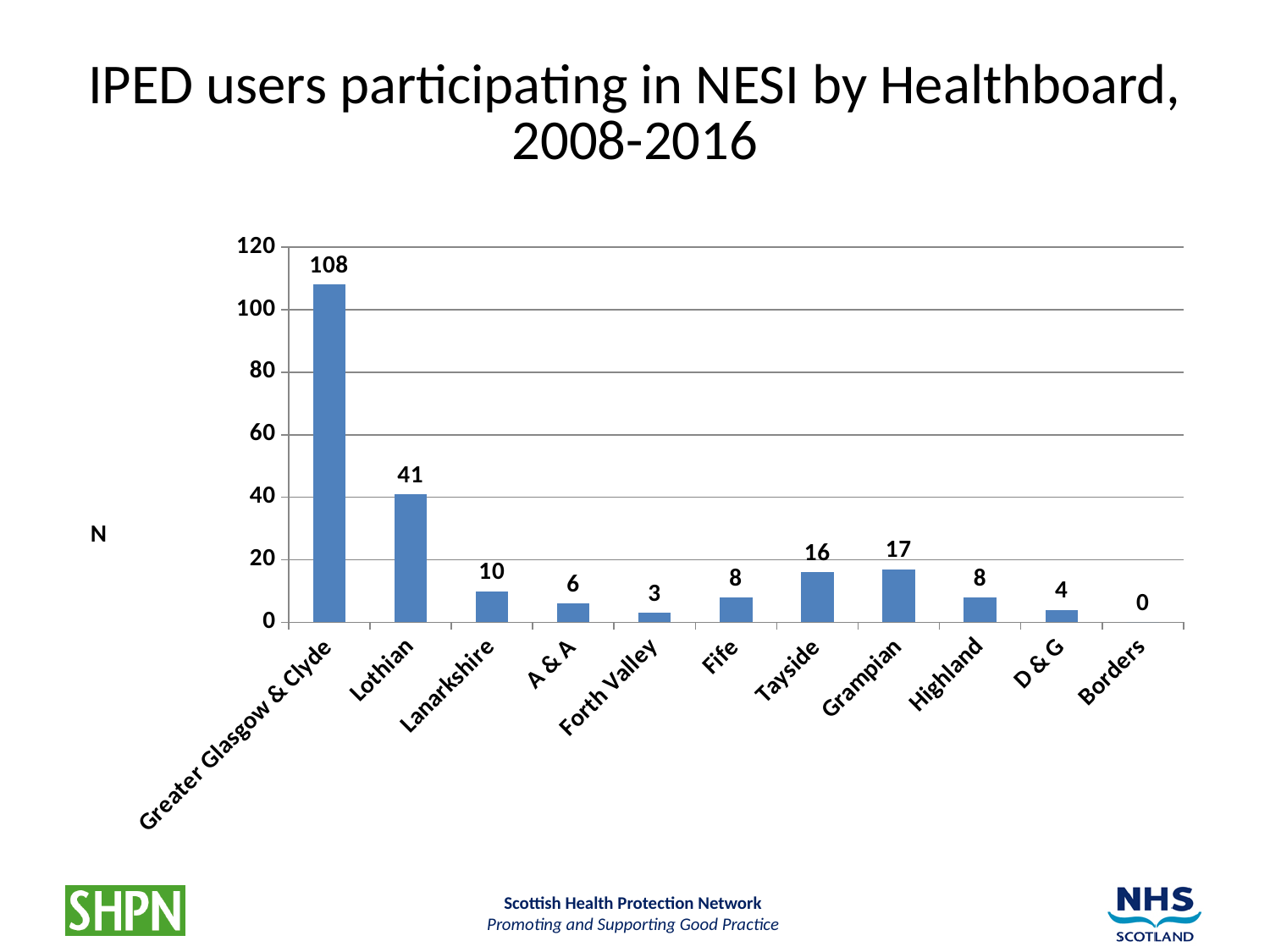
What is the value for Grampian? 17 Which healthboard has the highest value? Greater Glasgow & Clyde What is the value for Borders? 0 What is the title of the chart? IPED users participating in NESI by Healthboard, 2008-2016 Which is larger, the value for Tayside or the value for Lanarkshire? Tayside Which healthboard has the lowest value? Borders What is the difference between the values for Greater Glasgow & Clyde and Lothian? 67 What kind of chart is shown on the slide? Bar chart Is the value for Lothian greater or less than 40? greater How many healthboards are shown on the x axis? 11 What is the value for Lothian? 41 What is the value for Greater Glasgow & Clyde? 108